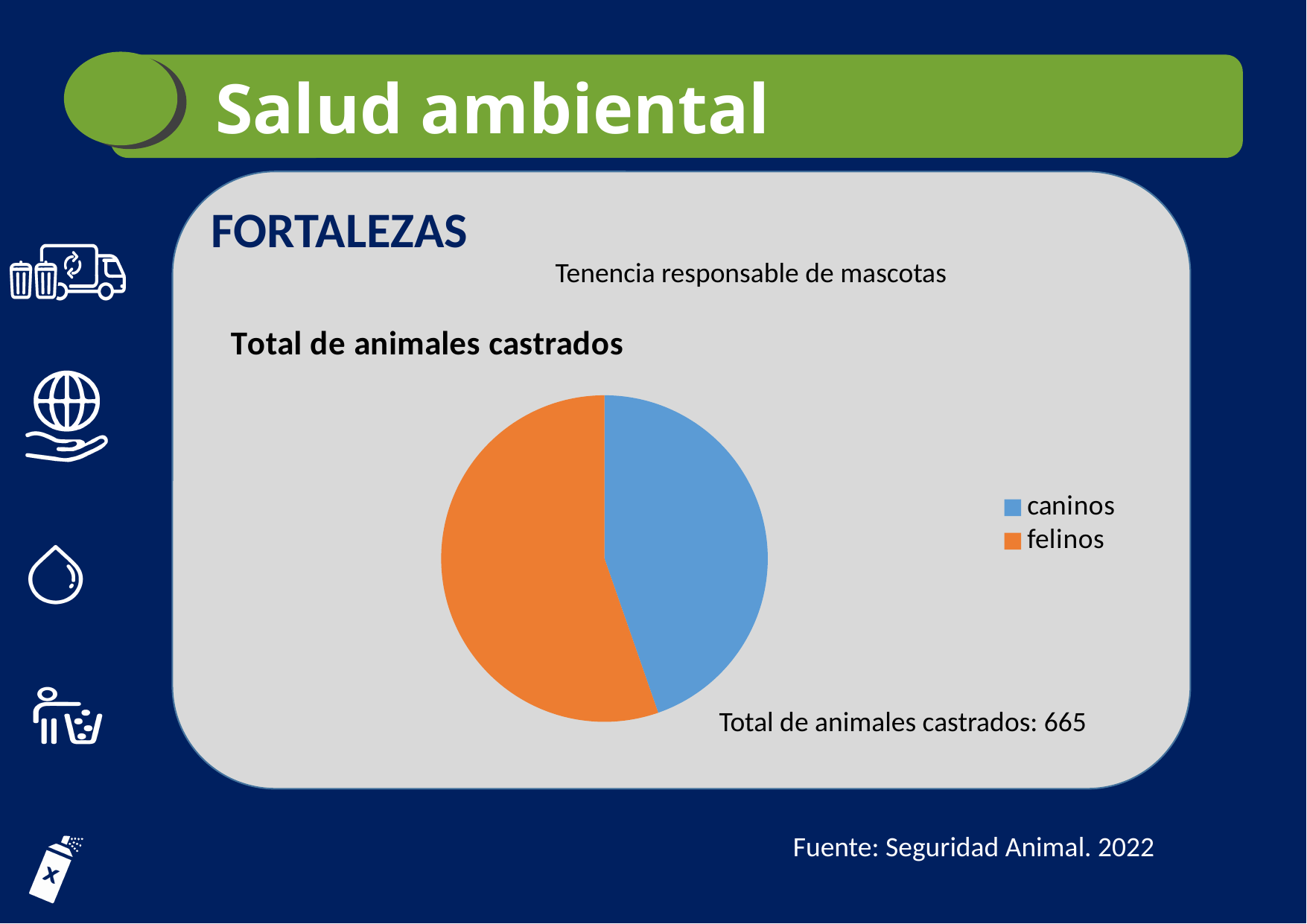
Which category has the smallest slice in the pie chart? caninos What kind of chart is shown on the slide? pie chart How many categories does the pie chart show? 2 What is the title of the pie chart? Total de animales castrados Which slice is larger in the pie chart, caninos or felinos? felinos Which category has the largest slice in the pie chart? felinos According to the text below the chart, what is the total number of animals castrated? 665 How many entries does the legend of the pie chart list? 2 Which colour represents caninos in the pie chart? blue